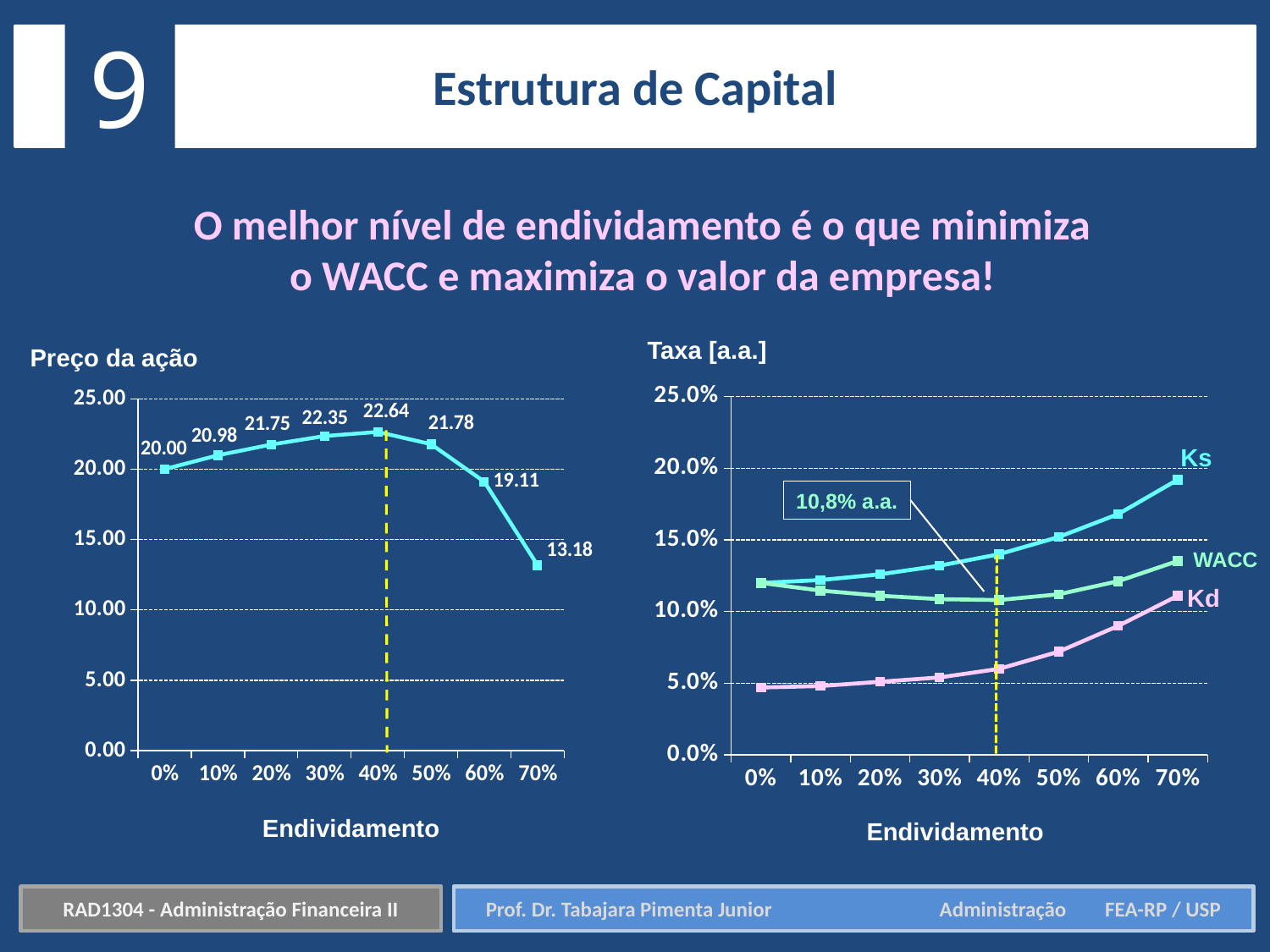
On the left chart (Preço da ação), how many debt levels are plotted on the x axis? 8 On the left chart (Preço da ação), what is the share price at 0% debt? 20.00 On the left chart (Preço da ação), what is the share price at 70% debt? 13.18 On the left chart (Preço da ação), at which debt level is the share price lowest? 70% What kind of chart is the right chart (Taxa [a.a.])? line chart On the right chart (Taxa [a.a.]), what is the WACC value at 40% debt? 10,8% a.a. On the left chart (Preço da ação), what is the share price at 40% debt? 22.64 On the right chart (Taxa [a.a.]), is the Kd value at 0% debt greater or less than 5.0%? less On the left chart (Preço da ação), what is the difference between the share price at 40% and at 70% debt? 9.46 On the left chart (Preço da ação), at which debt level is the share price highest? 40% On the left chart (Preço da ação), which is larger: the share price at 10% or at 50% debt? 50% On the right chart (Taxa [a.a.]), how many series are plotted? 3